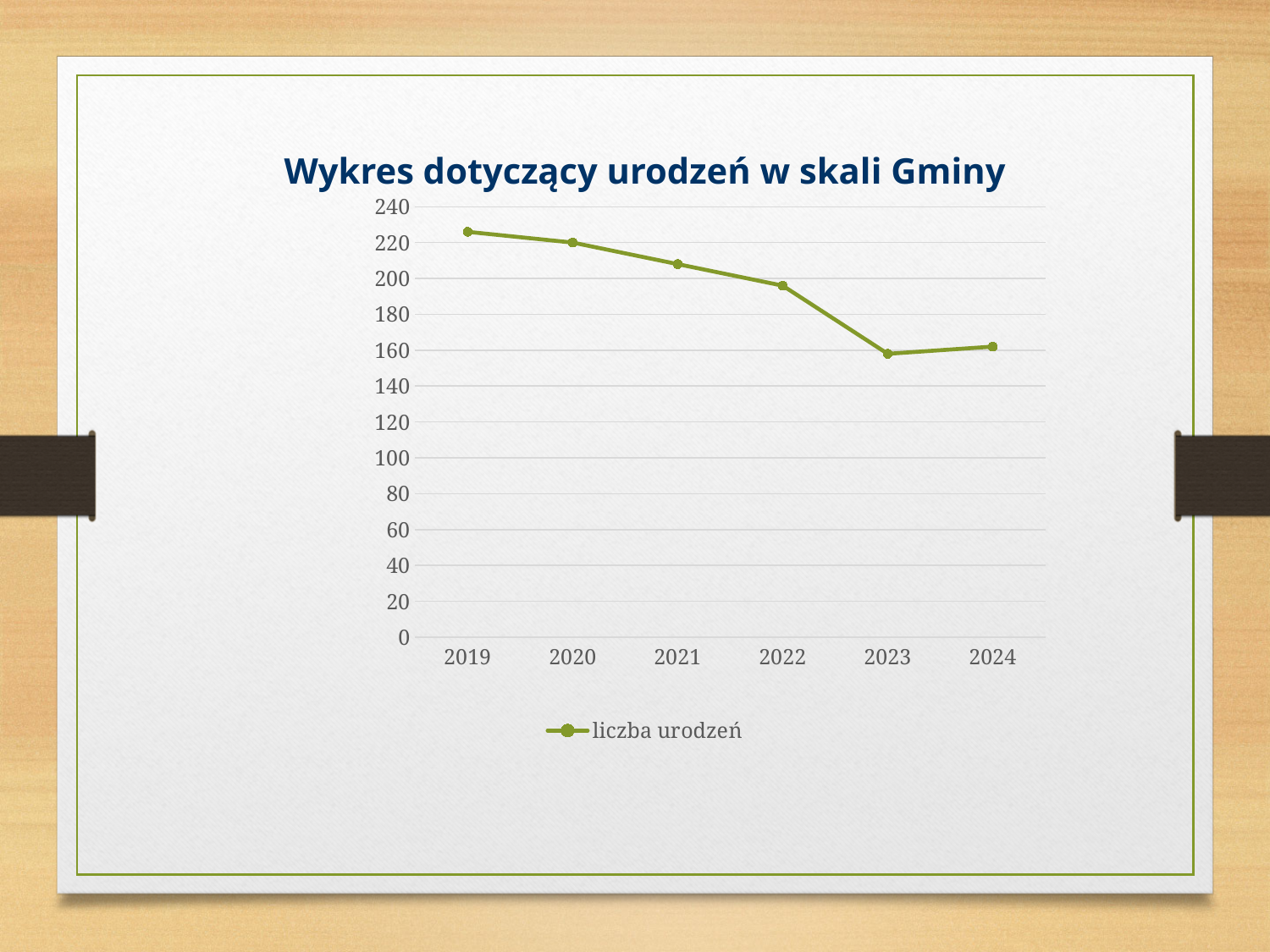
How many series does the legend list? 1 Is the value for 2019 greater or less than 220? greater Which year has a larger value, 2019 or 2024? 2019 Is the value for 2023 greater or less than 180? less What kind of chart is shown on the slide? line chart Which year has the highest number of births (liczba urodzeń)? 2019 What series name does the legend show? liczba urodzeń Is the value for 2022 greater or less than 200? less What is the title of the chart? Wykres dotyczący urodzeń w skali Gminy Which year has the lowest number of births (liczba urodzeń)? 2023 How many years are plotted on the x axis? 6